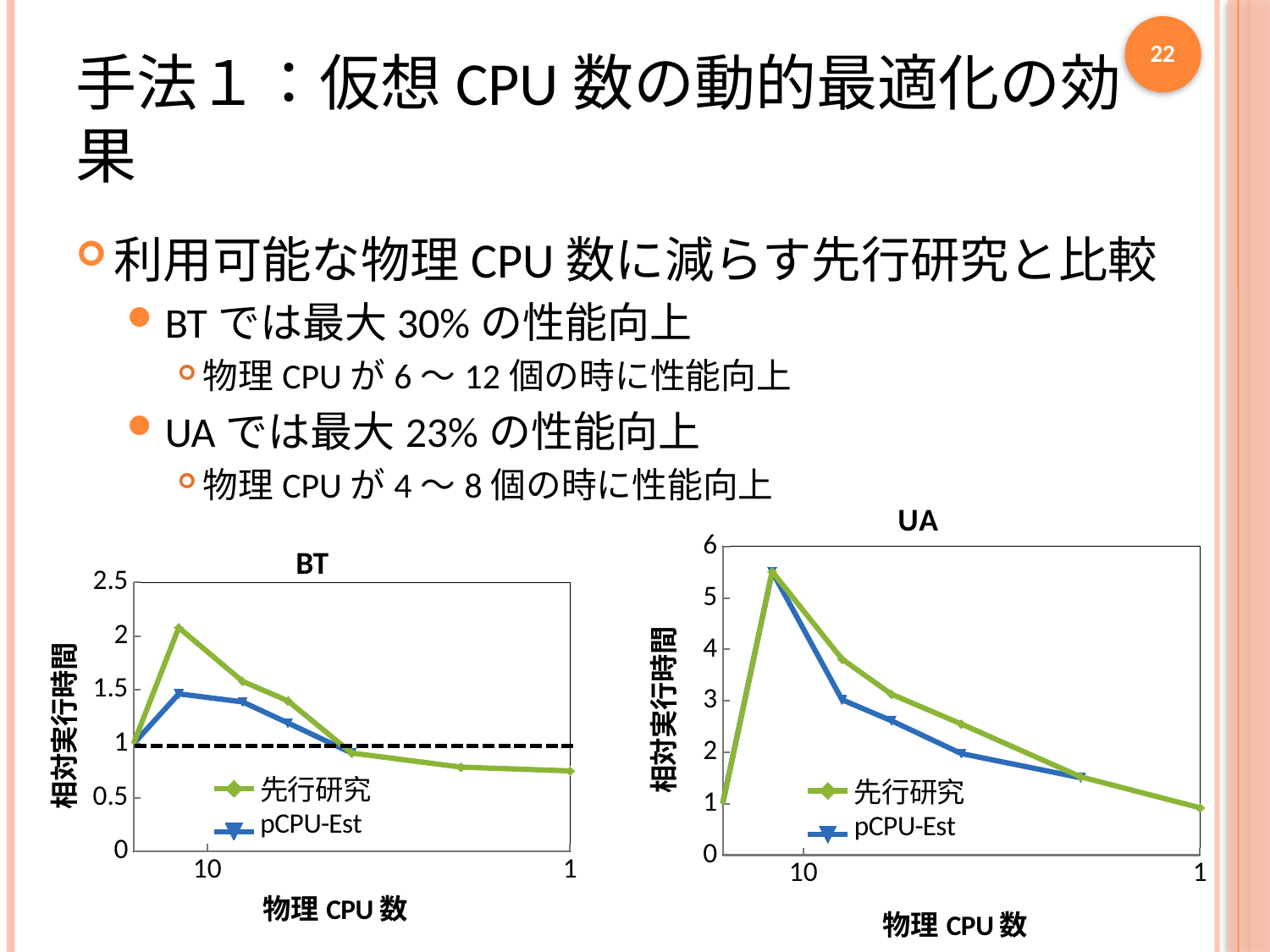
In the UA chart, after the peak, do the values of the 先行研究 series rise or fall as the x axis moves toward 1? fall What kind of chart is the BT chart? line chart How many series does the legend of the UA chart list? 2 What are the two series named in the legend of the BT chart? 先行研究 and pCPU-Est What is the y-axis title of the UA chart? 相対実行時間 In the BT chart, which series reaches the higher peak value, 先行研究 or pCPU-Est? 先行研究 In the UA chart, is the peak value of the 先行研究 series greater or less than 5? greater In the UA chart, which series has the higher value at the third point from the left, 先行研究 or pCPU-Est? 先行研究 In the BT chart, is the value of the 先行研究 series at 1 physical CPU greater or less than 1? less In the BT chart, is the peak value of the pCPU-Est series greater or less than 2? less